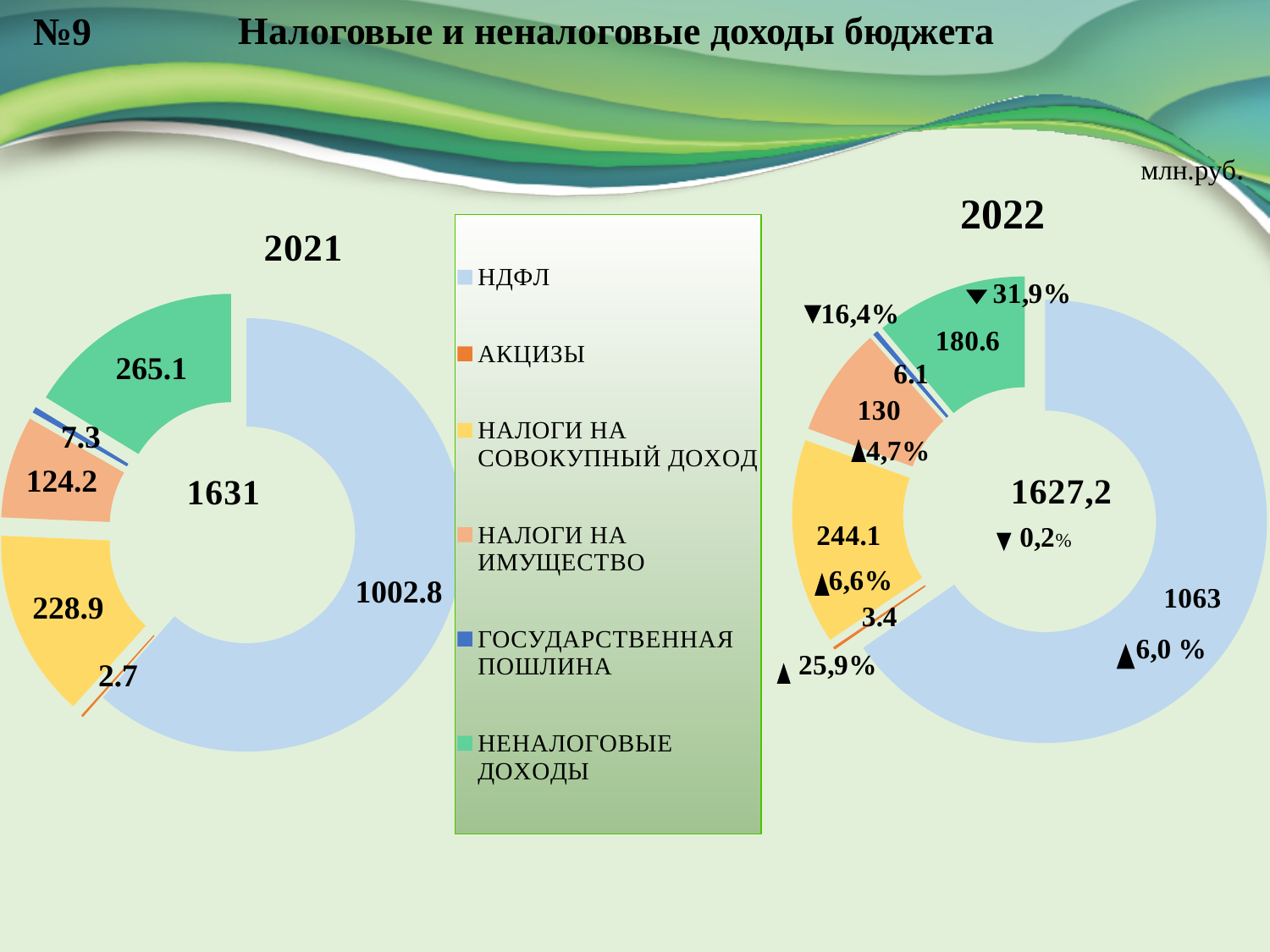
Which is larger on the 2021 chart: НАЛОГИ НА СОВОКУПНЫЙ ДОХОД or НЕНАЛОГОВЫЕ ДОХОДЫ? НЕНАЛОГОВЫЕ ДОХОДЫ On the 2021 chart, what is the value for НАЛОГИ НА ИМУЩЕСТВО? 124.2 On the 2022 chart, what is the value for НЕНАЛОГОВЫЕ ДОХОДЫ? 180.6 On the 2021 chart, which category has the largest value? НДФЛ What is the difference between the НДФЛ value on the 2022 chart and the НДФЛ value on the 2021 chart? 60.2 How many entries does the legend list? 6 How many categories does the 2022 chart show? 6 On the 2022 chart, what is the value for НАЛОГИ НА СОВОКУПНЫЙ ДОХОД? 244.1 On the 2021 chart, what is the value for НДФЛ? 1002.8 On the 2022 chart, which category has the smallest value? АКЦИЗЫ What total is shown in the centre of the 2022 chart? 1627,2 What kind of chart is the 2021 chart? Doughnut chart